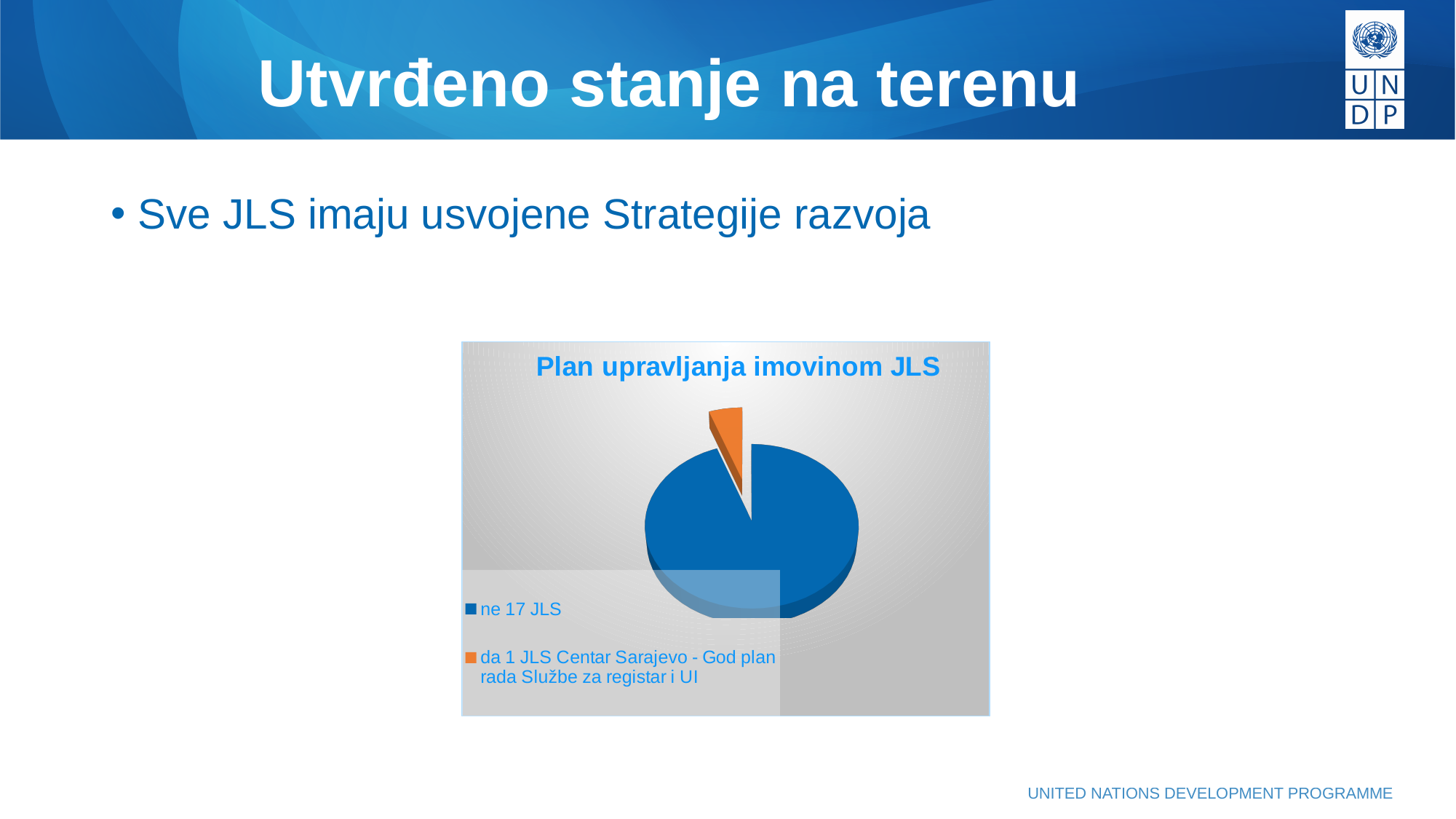
How many entries does the chart legend list? 2 What is the title of the chart? Plan upravljanja imovinom JLS How many JLS are in the 'da' category according to the legend? 1 JLS What colour is the 'ne 17 JLS' slice? blue Which slice of the pie chart is the smallest? da 1 JLS Centar Sarajevo - God plan rada Službe za registar i UI How many slices does the pie chart have? 2 How many JLS are in the 'ne' category according to the legend? 17 JLS Which is larger, the 'ne' slice or the 'da' slice? ne Which JLS is named in the legend as the one with a plan? Centar Sarajevo What type of chart is shown on the slide? pie chart Which slice of the pie chart is the largest? ne 17 JLS What is the difference between the number of JLS in the 'ne' category and the 'da' category? 16